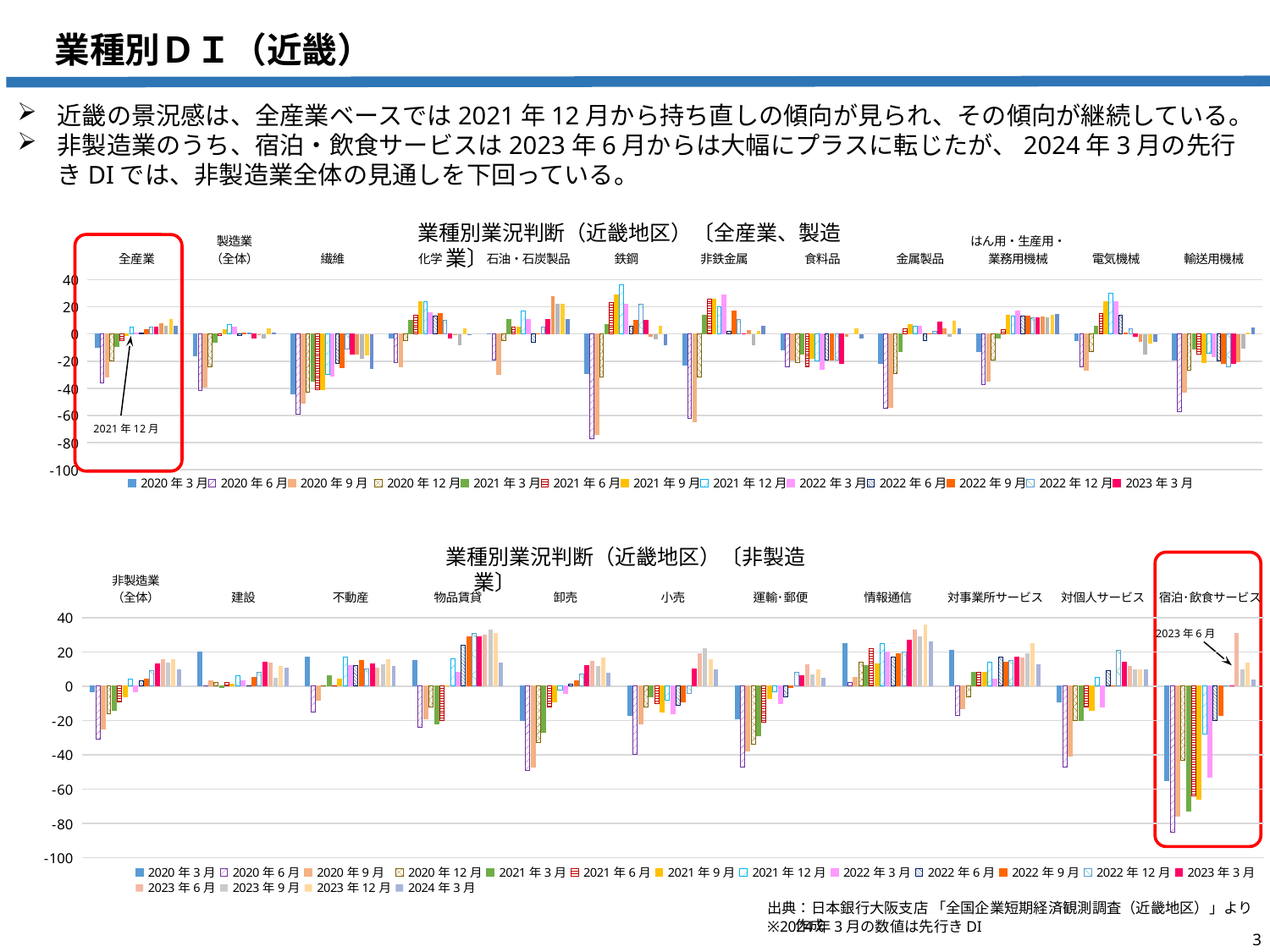
How many series does the legend of the bottom chart (非製造業) list? 17 In the bottom chart (非製造業), is the value for 情報通信 in 2023年12月 greater or less than 20? greater In the bottom chart (非製造業), is the value for 宿泊・飲食サービス in 2020年6月 greater or less than -60? less In the top chart (全産業、製造業), is the value for 鉄鋼 in 2020年9月 greater or less than -60? less Which category is highlighted with a red box in the bottom chart (非製造業)? 宿泊・飲食サービス How many series does the legend of the top chart (全産業、製造業) list? 13 How many industry categories are shown on the x axis of the top chart (全産業、製造業)? 12 How many industry categories are shown on the x axis of the bottom chart (非製造業)? 11 What kind of chart is the top chart titled 業種別業況判断（近畿地区）〔全産業、製造業〕? bar chart